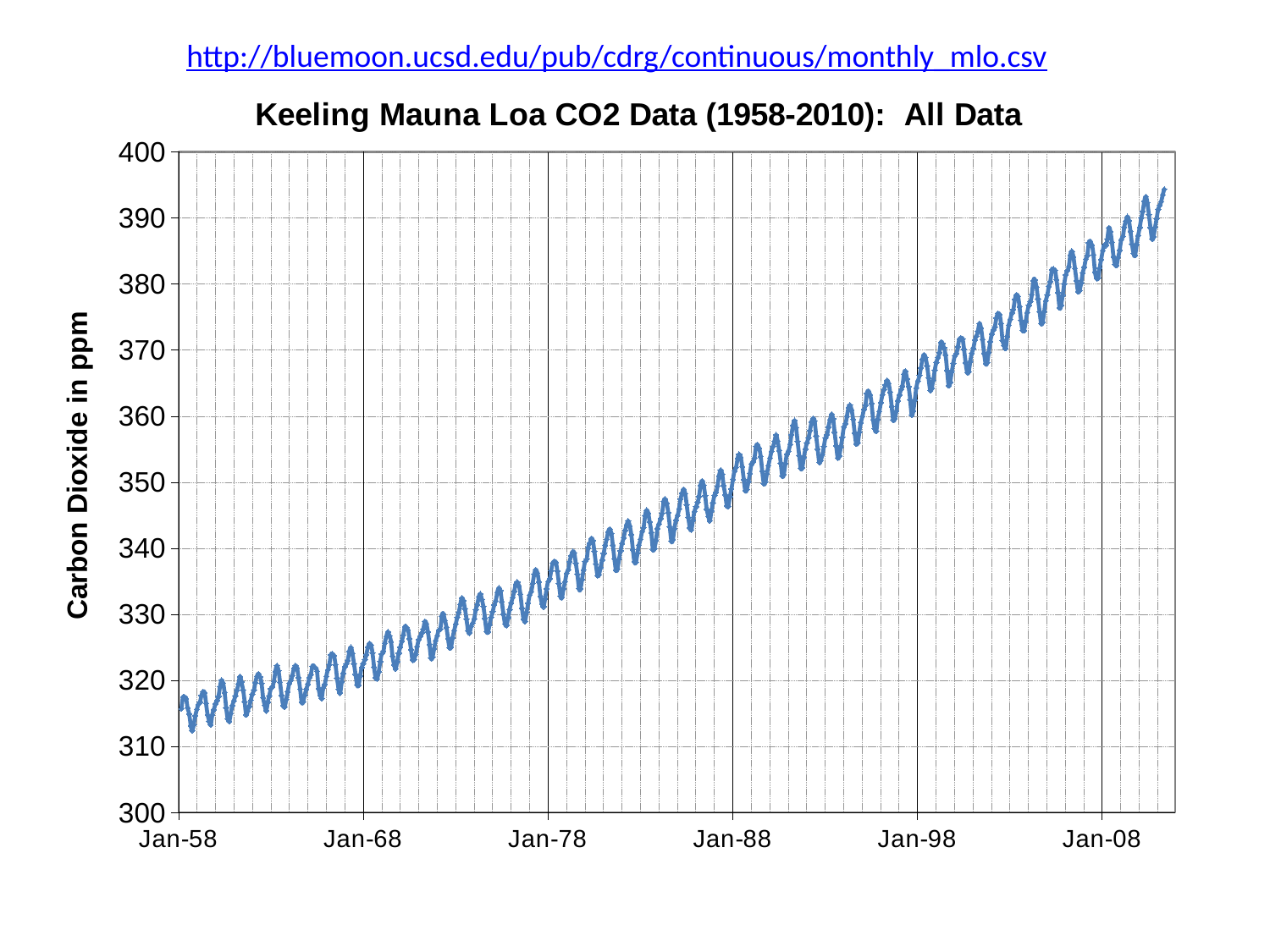
What is the title of the chart? Keeling Mauna Loa CO2 Data (1958-2010): All Data Is the CO2 value at Jan-58 greater or less than 320? less Is the CO2 value at Jan-78 greater or less than 330? greater How many labelled tick marks are shown on the horizontal axis? 6 Is the CO2 value at Jan-08 greater or less than 380? greater Which labelled year on the horizontal axis has the lowest CO2 values? Jan-58 Do the CO2 values generally rise or fall from Jan-58 to the end of the series? rise What kind of chart is shown on the slide? line chart What is the label of the vertical axis? Carbon Dioxide in ppm